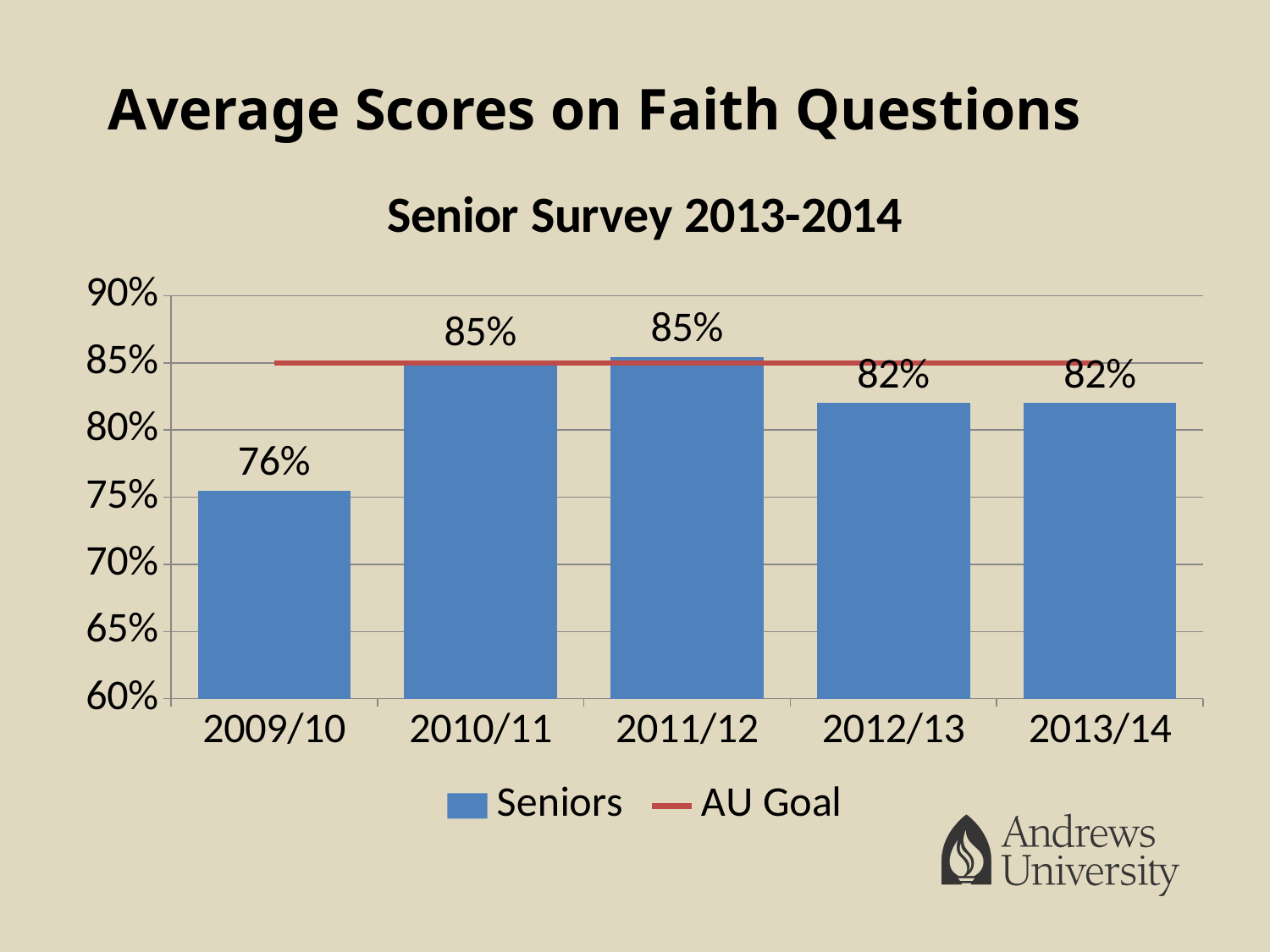
How many series does the legend list? 2 Which year has the lowest Seniors value? 2009/10 What is the Seniors value for 2010/11? 85% What is the Seniors value for 2012/13? 82% How many years are shown on the x axis? 5 Is the Seniors value for 2009/10 greater or less than 80%? less What is the difference between the Seniors values for 2011/12 and 2009/10? 9% What is the difference between the Seniors values for 2010/11 and 2013/14? 3% Which is larger, the Seniors value for 2012/13 or for 2009/10? 2012/13 What kind of chart is shown? combination bar and line chart What is the title of the chart? Senior Survey 2013-2014 What is the Seniors value for 2009/10? 76%